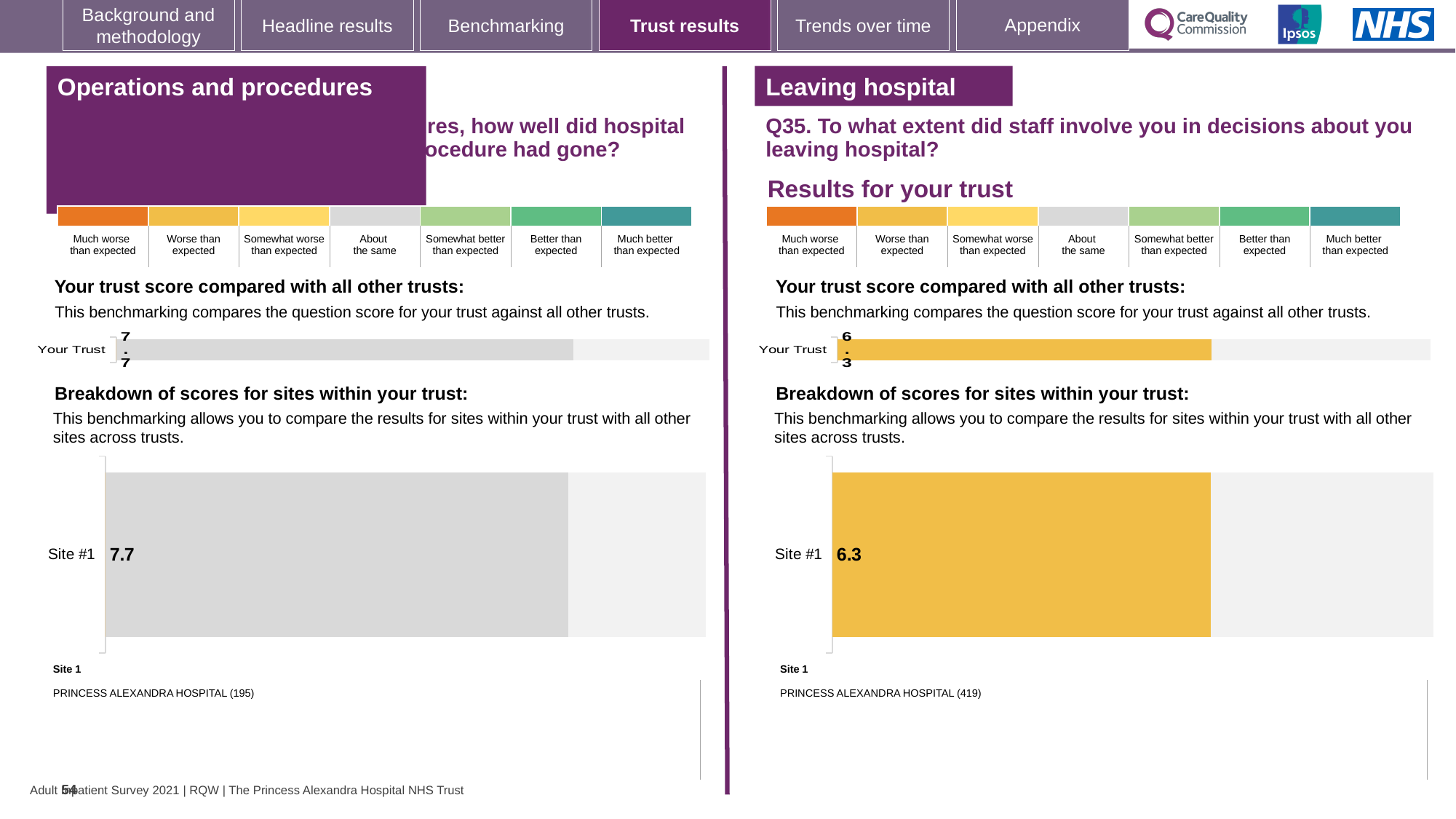
In the 'Breakdown of scores for sites within your trust' chart on the right-hand side (Q35), what score is shown for Site #1? 6.3 What type of chart is used to show the 'Your Trust' score in the right-hand 'Leaving hospital' section? Bar chart In the right-hand 'Leaving hospital' section, which benchmark category does the colour of the 'Your Trust' bar correspond to? Worse than expected How many sites are shown in the 'Breakdown of scores for sites within your trust' chart on the right-hand side? 1 In the 'Breakdown of scores for sites within your trust' chart on the left-hand side, what score is shown for Site #1? 7.7 On the right-hand 'Leaving hospital' section (Q35), what is the 'Your Trust' score shown in the trust benchmarking chart? 6.3 What is the difference between the Site #1 score in the left-hand chart (7.7) and the Site #1 score in the right-hand Q35 chart (6.3)? 1.4 In the left-hand 'Operations and procedures' section, which benchmark category does the colour of the 'Your Trust' bar correspond to? About the same Which is larger: the 'Your Trust' score in the left-hand 'Operations and procedures' chart or the 'Your Trust' score in the right-hand 'Leaving hospital' chart? Operations and procedures (7.7) On the left-hand 'Operations and procedures' section, what is the 'Your Trust' score shown in the trust benchmarking chart? 7.7 Which site is listed as Site 1 beneath the right-hand breakdown chart? PRINCESS ALEXANDRA HOSPITAL (419) How many categories does the colour key above the 'Your trust score compared with all other trusts' section on the right-hand side list? 7